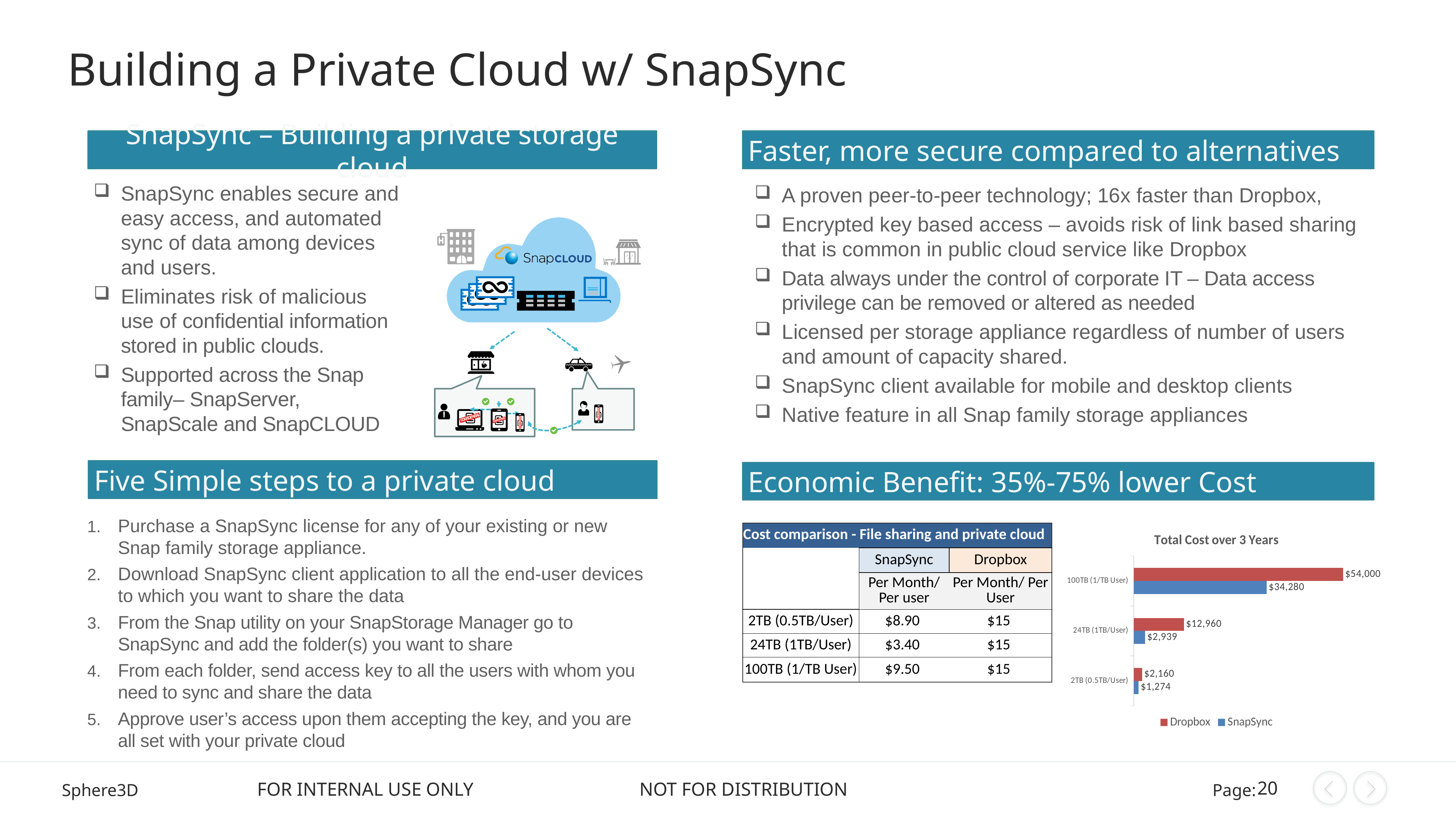
What is the title of the chart on the slide? Total Cost over 3 Years What kind of chart is "Total Cost over 3 Years"? bar chart In the "Total Cost over 3 Years" chart, which is larger for 24TB (1TB/User): Dropbox or SnapSync? Dropbox In the "Total Cost over 3 Years" chart, what is the SnapSync value for 2TB (0.5TB/User)? $1,274 How many series does the legend of the "Total Cost over 3 Years" chart list? 2 In the "Total Cost over 3 Years" chart, what is the difference between the Dropbox and SnapSync values for 100TB (1/TB User)? $19,720 How many categories are shown in the "Total Cost over 3 Years" chart? 3 In the "Total Cost over 3 Years" chart, what is the Dropbox value for 100TB (1/TB User)? $54,000 In the "Total Cost over 3 Years" chart, which category has the lowest SnapSync value? 2TB (0.5TB/User) In the "Total Cost over 3 Years" chart, what is the SnapSync value for 24TB (1TB/User)? $2,939 In the "Total Cost over 3 Years" chart, which series is shown in red? Dropbox In the "Total Cost over 3 Years" chart, which category has the highest Dropbox value? 100TB (1/TB User)